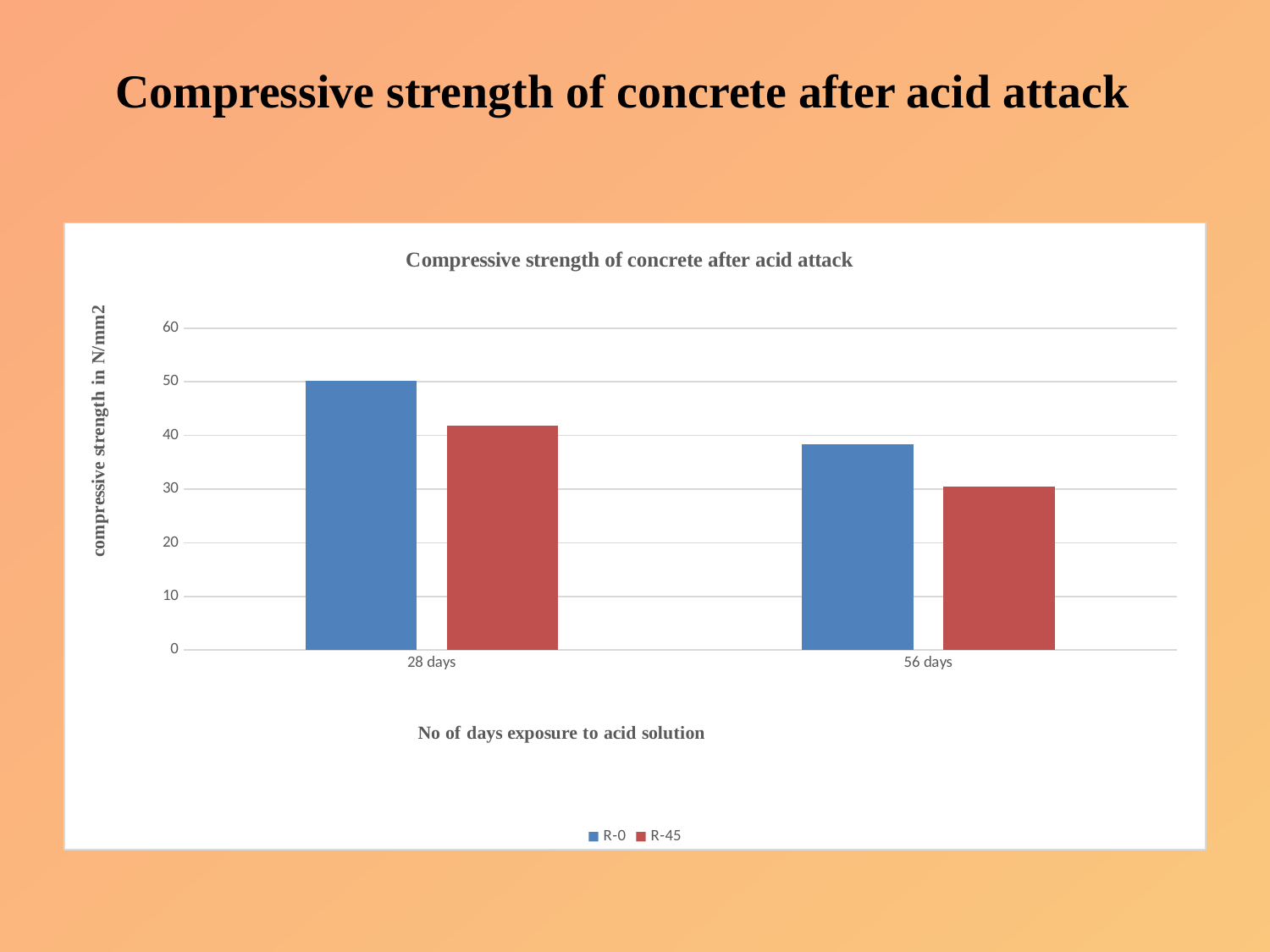
Which series and category has the highest bar? R-0 at 28 days How many exposure-duration categories are shown on the x axis? 2 How many series does the legend list? 2 Do the compressive strength values for R-0 rise or fall from 28 days to 56 days? fall At 28 days, which series has the larger compressive strength, R-0 or R-45? R-0 Is the value for R-45 at 28 days greater or less than 40? greater What kind of chart is shown on the slide? bar chart Which series and category has the lowest bar? R-45 at 56 days Which colour represents the R-45 series? red What is the label of the y axis? compressive strength in N/mm2 At 56 days, which series has the larger compressive strength, R-0 or R-45? R-0 Is the value for R-0 at 56 days greater or less than 40? less